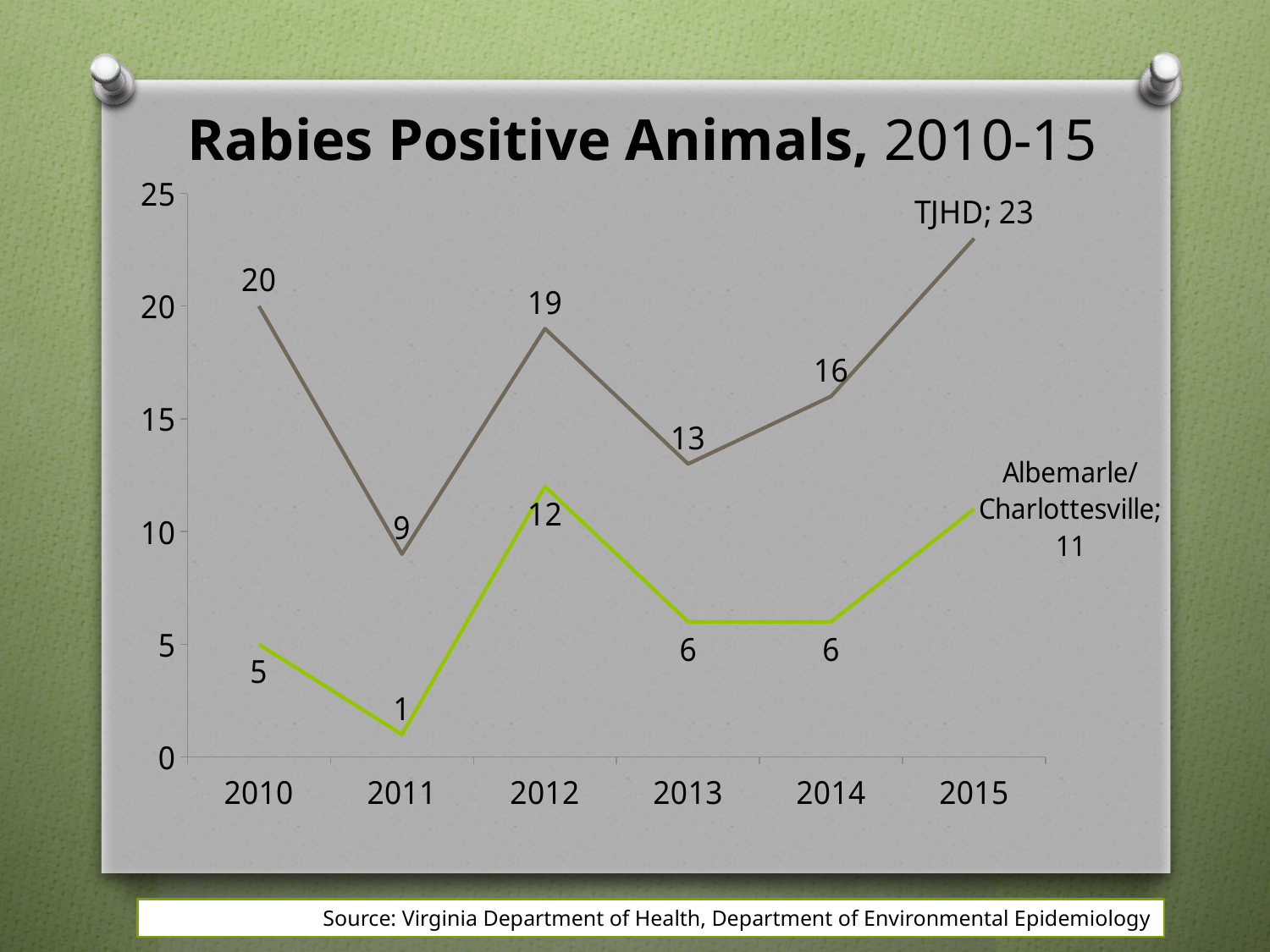
How many series are plotted on the chart? 2 What is the TJHD value for 2013? 13 What is the title of the chart? Rabies Positive Animals, 2010-15 What is the difference between the TJHD and Albemarle/Charlottesville values in 2012? 7 Does the TJHD series rise or fall from 2013 to 2015? Rise Which is larger, the TJHD value in 2010 or the TJHD value in 2012? 2010 What is the TJHD value for 2015? 23 What is the Albemarle/Charlottesville value for 2011? 1 What kind of chart is shown on the slide? Line chart In which year is the Albemarle/Charlottesville series at its lowest? 2011 How many years are shown on the x axis? 6 In which year is the TJHD series at its highest? 2015